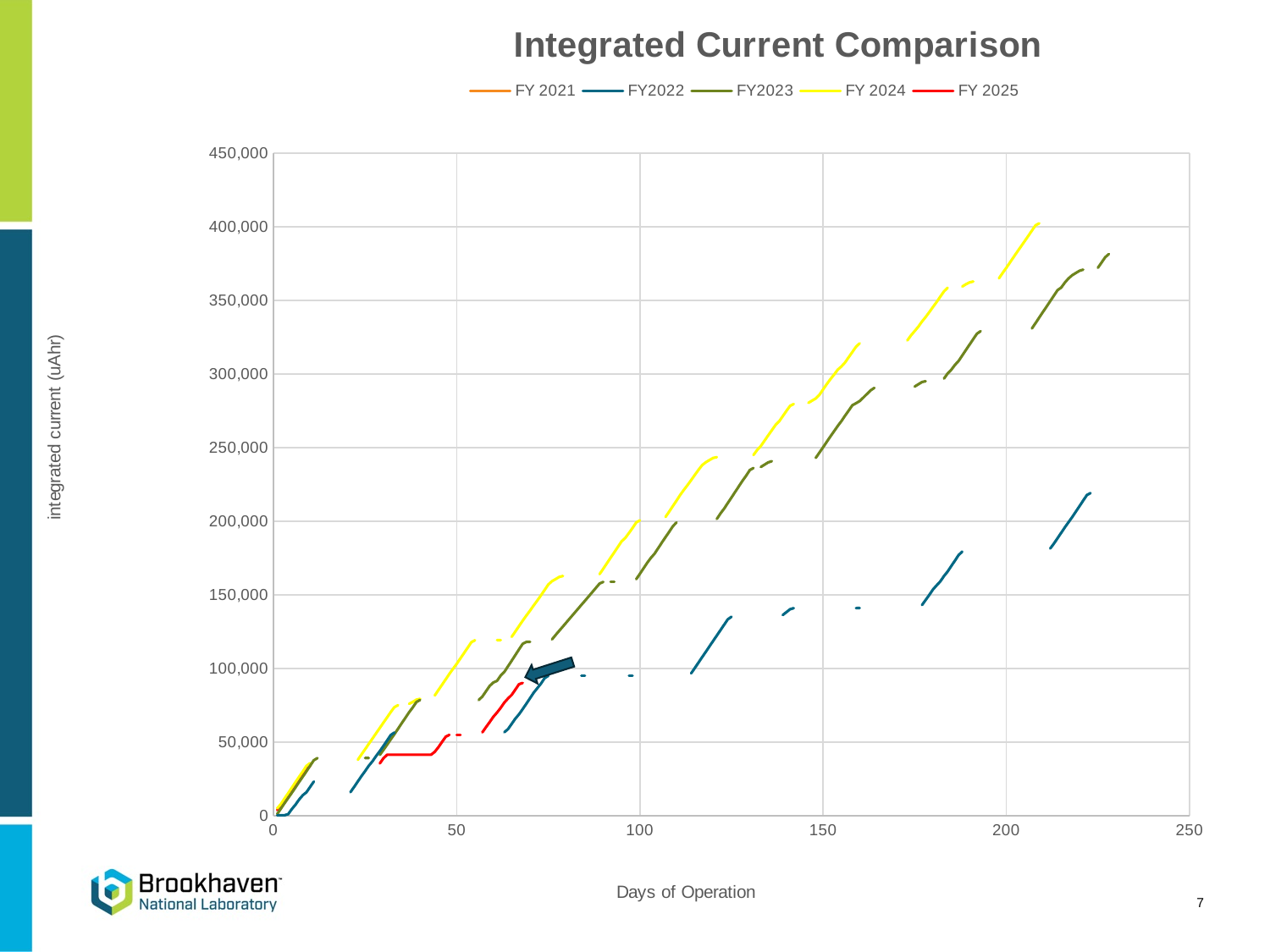
Is the highest value reached by FY 2024 greater or less than 350,000? greater What is the label of the x axis? Days of Operation Is the highest value reached by FY 2025 greater or less than 100,000? less Which series reaches the highest integrated current on the chart? FY 2024 Is the highest value reached by FY2022 greater or less than 200,000? greater At 200 days of operation, which series has the higher value, FY 2024 or FY2022? FY 2024 How many series does the legend list? 5 Do the integrated current values rise or fall as days of operation increase? rise At 150 days of operation, which series has the higher value, FY 2024 or FY2023? FY 2024 What is the highest value shown on the y axis? 450,000 What is the title of the chart? Integrated Current Comparison What kind of chart is shown on the slide? line chart